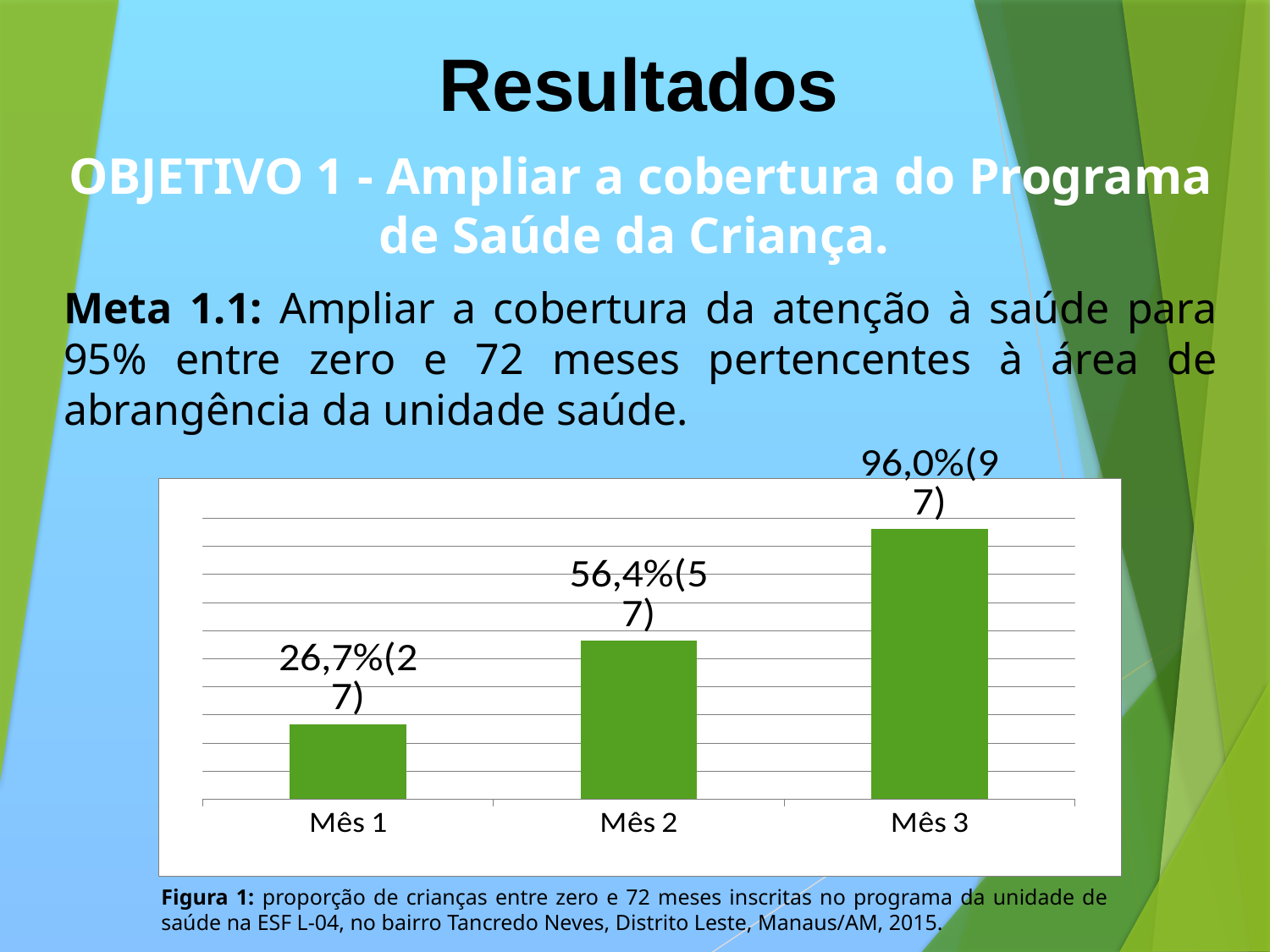
Which month has the highest value? Mês 3 What value is shown for Mês 2? 56,4%(57) How many more children are counted in Mês 3 than in Mês 2? 40 What kind of chart is shown on the slide? Bar chart What value is shown for Mês 1? 26,7%(27) Which month has the lowest value? Mês 1 What value is shown for Mês 3? 96,0%(97) Which is larger, the value for Mês 2 or the value for Mês 3? Mês 3 How many months (categories) are shown on the chart? 3 What is the difference in percentage points between Mês 3 and Mês 1? 69,3 What is the difference in percentage points between Mês 2 and Mês 1? 29,7 Do the values rise or fall from Mês 1 to Mês 3? Rise